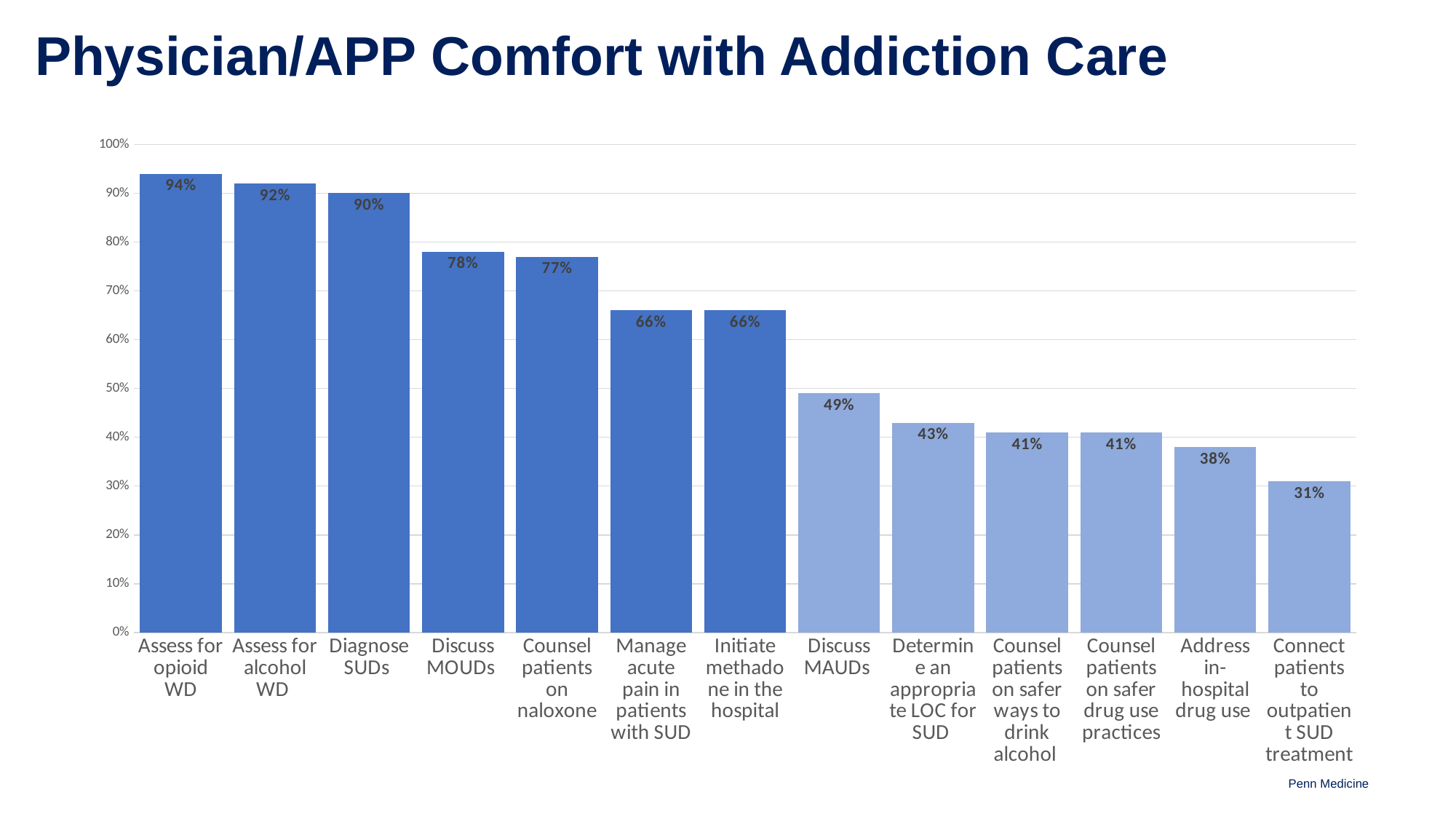
What is the value for Assess for opioid WD? 94% What is the title of the chart? Physician/APP Comfort with Addiction Care What kind of chart is shown on the slide? bar chart Which category has the highest value? Assess for opioid WD What is the value for Connect patients to outpatient SUD treatment? 31% What is the value for Discuss MAUDs? 49% Do the values rise or fall from left to right along the x axis? fall Which is larger, the value for Discuss MAUDs or the value for Address in-hospital drug use? Discuss MAUDs Is the value for Counsel patients on naloxone greater or less than 70%? greater What is the difference between the values for Diagnose SUDs and Discuss MOUDs? 12% How many categories are shown in the chart? 13 Which category has the lowest value? Connect patients to outpatient SUD treatment